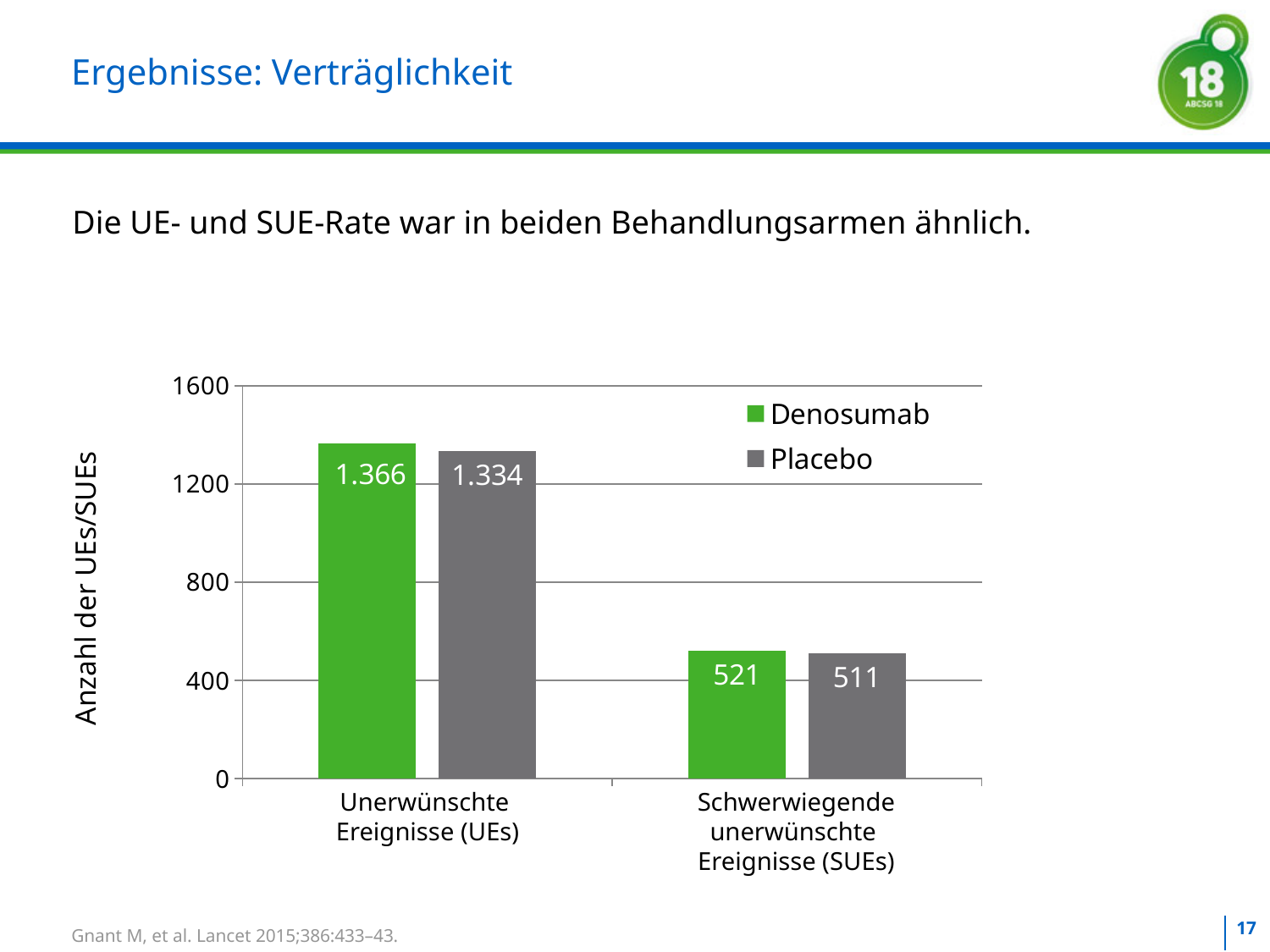
What kind of chart is shown on the slide? bar chart Which category has the lowest value for Placebo? Schwerwiegende unerwünschte Ereignisse (SUEs) What is the value for Placebo in the Schwerwiegende unerwünschte Ereignisse (SUEs) category? 511 Is the Denosumab value for Unerwünschte Ereignisse (UEs) greater or less than 1200? greater What is the value for Denosumab in the Unerwünschte Ereignisse (UEs) category? 1.366 How many series does the legend list? 2 Which category has the highest value for Denosumab? Unerwünschte Ereignisse (UEs) What is the difference between the Denosumab and Placebo values for Unerwünschte Ereignisse (UEs)? 32 What is the value for Denosumab in the Schwerwiegende unerwünschte Ereignisse (SUEs) category? 521 What is the value for Placebo in the Unerwünschte Ereignisse (UEs) category? 1.334 What is the difference between the Denosumab and Placebo values for Schwerwiegende unerwünschte Ereignisse (SUEs)? 10 What is the label of the y axis? Anzahl der UEs/SUEs